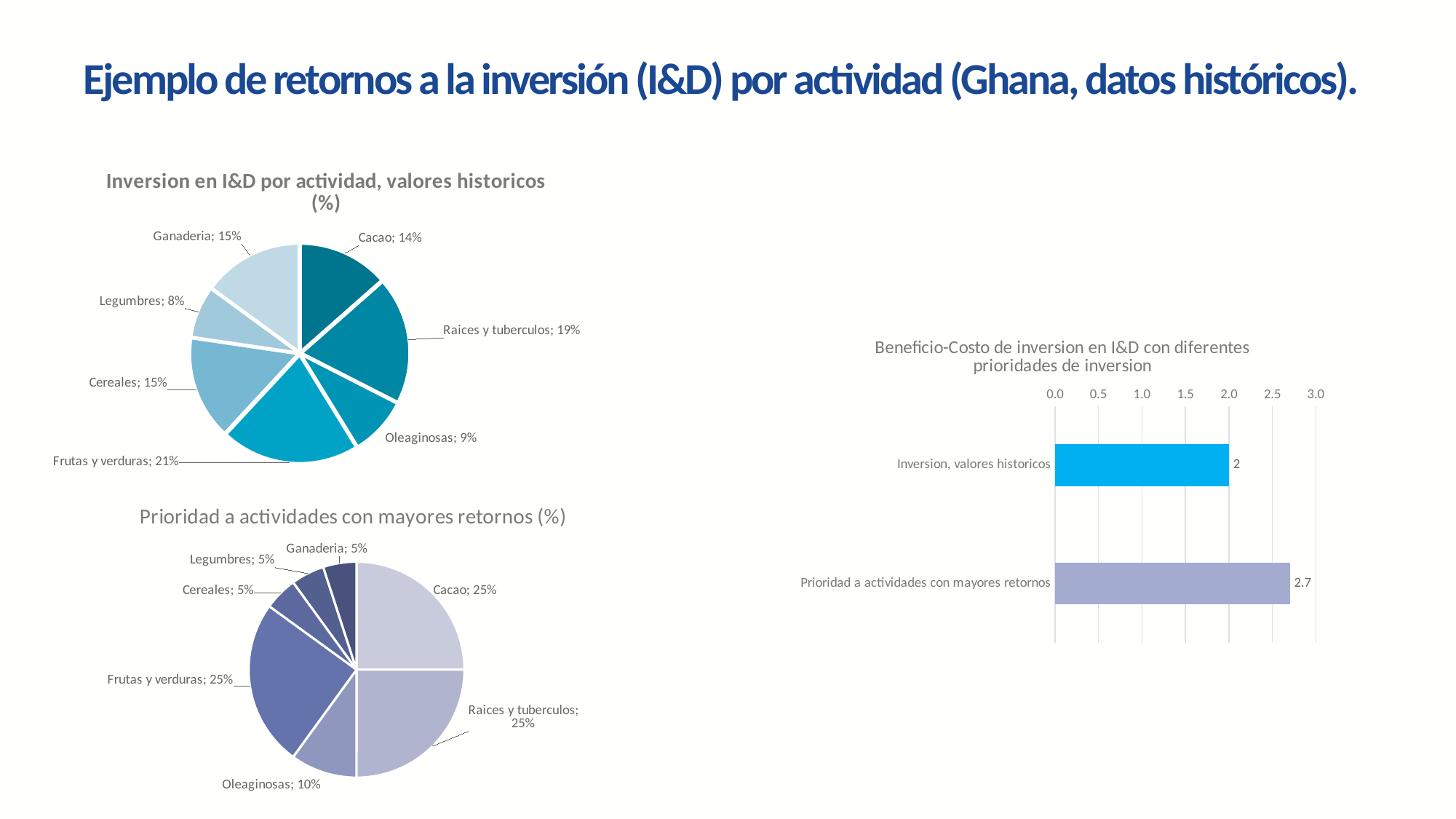
In the pie chart 'Inversion en I&D por actividad, valores historicos (%)', what is the difference between the shares of Frutas y verduras and Oleaginosas? 12% In the pie chart 'Inversion en I&D por actividad, valores historicos (%)', which activity has the smallest share? Legumbres In the pie chart 'Inversion en I&D por actividad, valores historicos (%)', which activity has the largest share? Frutas y verduras In the pie chart 'Prioridad a actividades con mayores retornos (%)', what is the share for Ganaderia? 5% In the chart 'Beneficio-Costo de inversion en I&D con diferentes prioridades de inversion', what is the value for 'Prioridad a actividades con mayores retornos'? 2.7 In the chart 'Beneficio-Costo de inversion en I&D con diferentes prioridades de inversion', what is the difference between the two bars? 0.7 In the pie chart 'Prioridad a actividades con mayores retornos (%)', what is the share for Oleaginosas? 10% What kind of chart is 'Beneficio-Costo de inversion en I&D con diferentes prioridades de inversion'? Bar chart In the pie chart 'Prioridad a actividades con mayores retornos (%)', which is larger, the share for Cacao or the share for Cereales? Cacao In the pie chart 'Inversion en I&D por actividad, valores historicos (%)', what is the share for Raices y tuberculos? 19% In the pie chart 'Inversion en I&D por actividad, valores historicos (%)', how many activities are shown? 7 In the chart 'Beneficio-Costo de inversion en I&D con diferentes prioridades de inversion', what is the value for 'Inversion, valores historicos'? 2